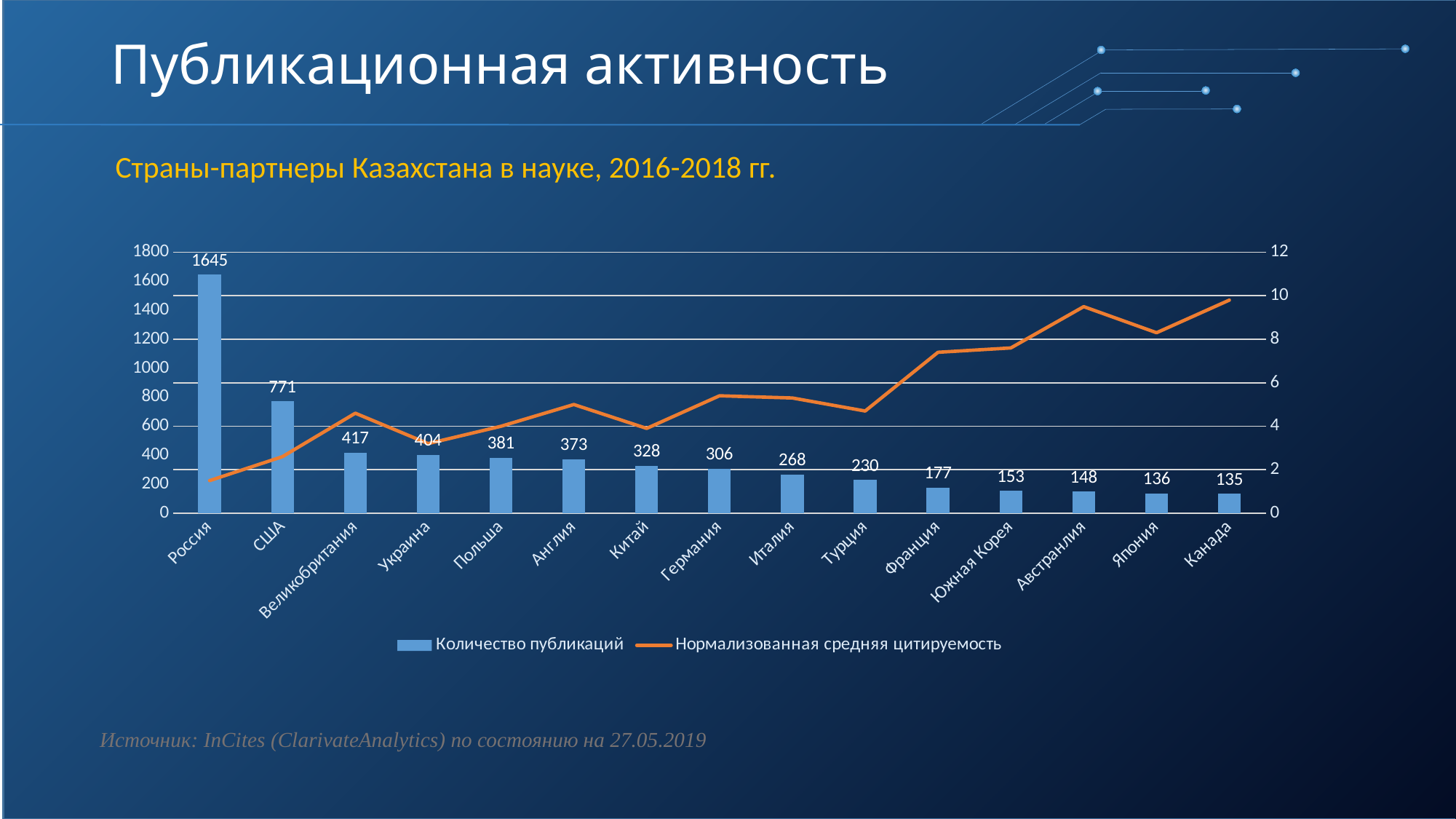
Is the normalized average citation (Нормализованная средняя цитируемость) value for Канада greater or less than 8? greater What kind of chart is used for the Количество публикаций series? bar chart Which country has the lowest number of publications? Канада What is the difference in number of publications between Россия and США? 874 How many series does the legend list? 2 What is the number of publications (Количество публикаций) for Россия? 1645 Is the normalized average citation value for Россия greater or less than 2? less What is the number of publications for Германия? 306 Do the number of publications values rise or fall from Россия to Канада along the x axis? fall How many countries are shown on the x axis? 15 Which has more publications, Великобритания or Украина? Великобритания Which country has the highest number of publications? Россия